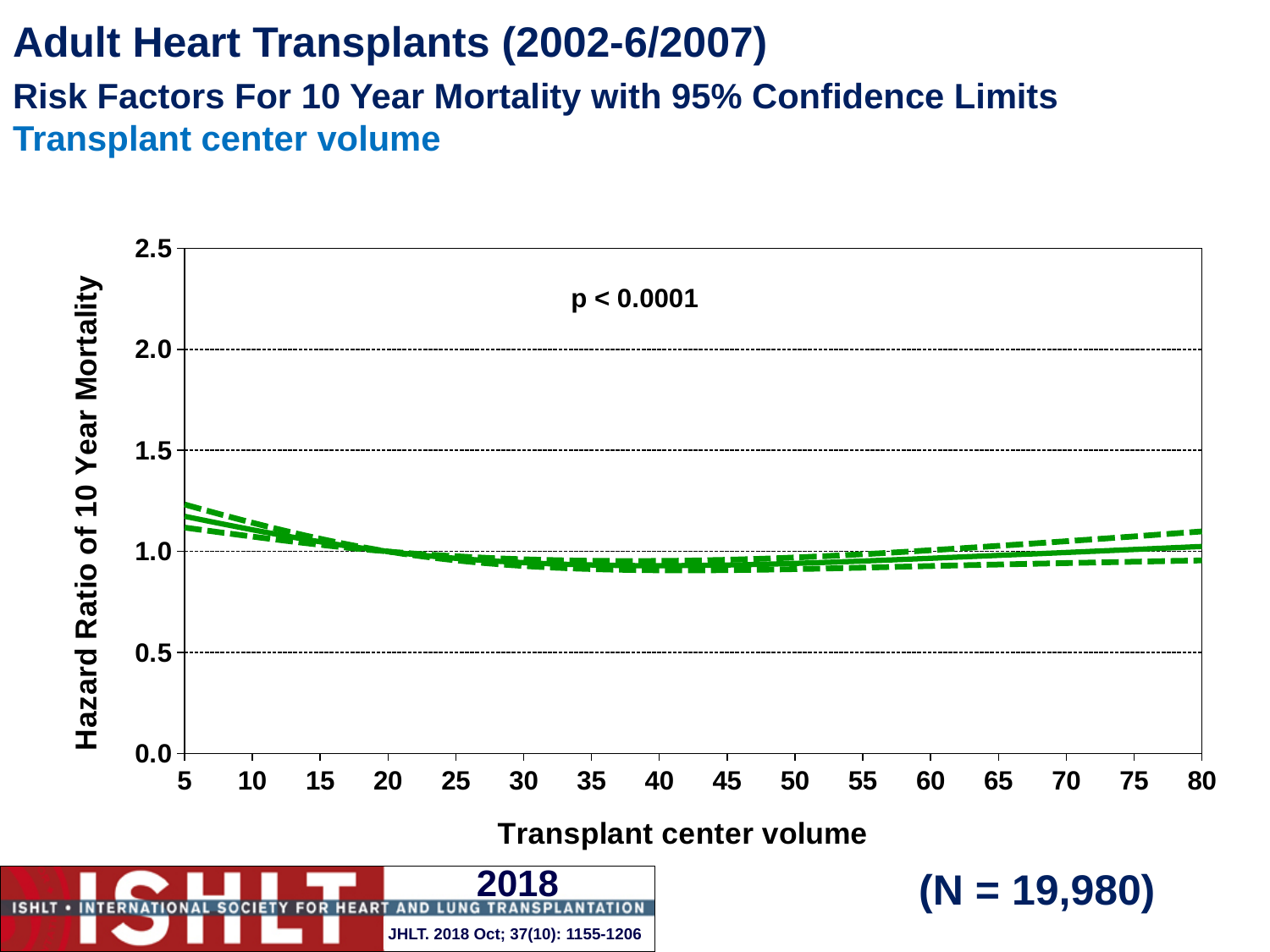
Is the hazard ratio at a transplant center volume of 5 greater or less than 1.0? greater What is the sample size (N) shown on the slide? 19,980 How many tick labels are shown on the y axis? 6 What kind of chart is shown on the slide? line chart Which has the higher hazard ratio: a transplant center volume of 5 or a volume of 40? 5 Does the hazard ratio rise or fall as transplant center volume increases from 5 to 40? fall How many tick labels are shown on the x axis (transplant center volume)? 16 How does the hazard ratio change across the full range of transplant center volume from 5 to 80? falls then rises slightly Is the hazard ratio at a transplant center volume of 30 greater or less than 1.5? less Is the hazard ratio at a transplant center volume of 40 greater or less than 1.0? less What p-value is printed on the chart? p < 0.0001